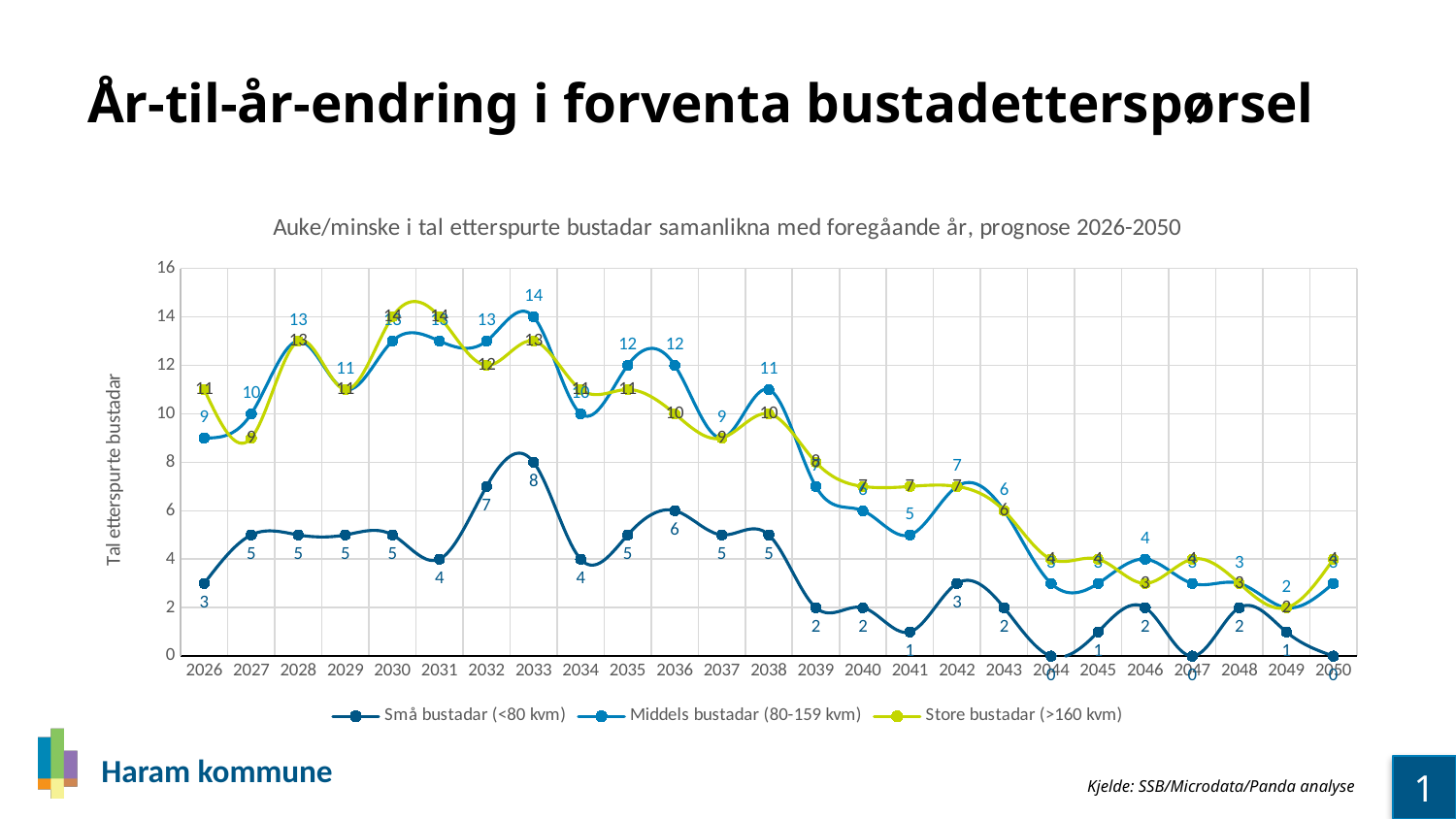
How many series does the legend list? 3 What kind of chart is shown on the slide? line chart What is the value for Store bustadar (>160 kvm) in 2039? 8 In which year does Middels bustadar (80-159 kvm) reach its highest value? 2033 What is the value for Middels bustadar (80-159 kvm) in 2041? 5 What is the value for Middels bustadar (80-159 kvm) in 2033? 14 How many years are plotted along the x axis? 25 In 2041, which is larger: Middels bustadar (80-159 kvm) or Store bustadar (>160 kvm)? Store bustadar (>160 kvm) What is the value for Små bustadar (<80 kvm) in 2033? 8 What is the difference between Middels bustadar (80-159 kvm) and Små bustadar (<80 kvm) in 2033? 6 In which year does Små bustadar (<80 kvm) reach its highest value? 2033 Does the Store bustadar (>160 kvm) series generally rise or fall from 2033 to 2049? fall